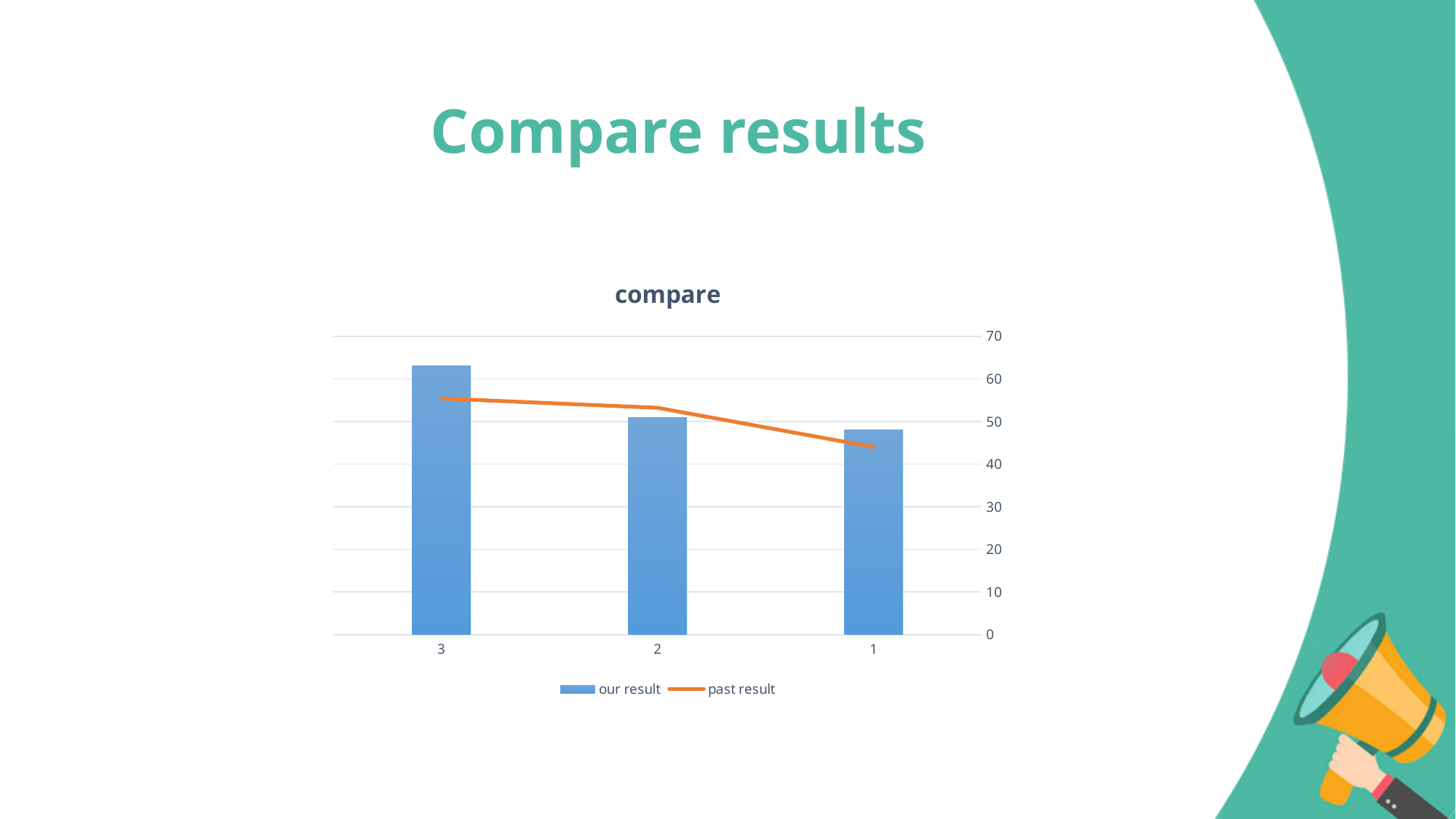
Which category has the lowest bar for "our result"? 1 What is the title of the chart? compare For category 3, which is larger: "our result" or "past result"? our result Is the "our result" value for category 3 greater or less than 60? greater Which category has the highest bar for "our result"? 3 How many categories are shown on the x axis? 3 Is the "past result" value for category 1 greater or less than 50? less Does the "past result" line rise or fall from left to right across the x axis? fall How many series does the legend list? 2 Is the "past result" value for category 3 greater or less than 60? less Which series is drawn as a line rather than bars? past result